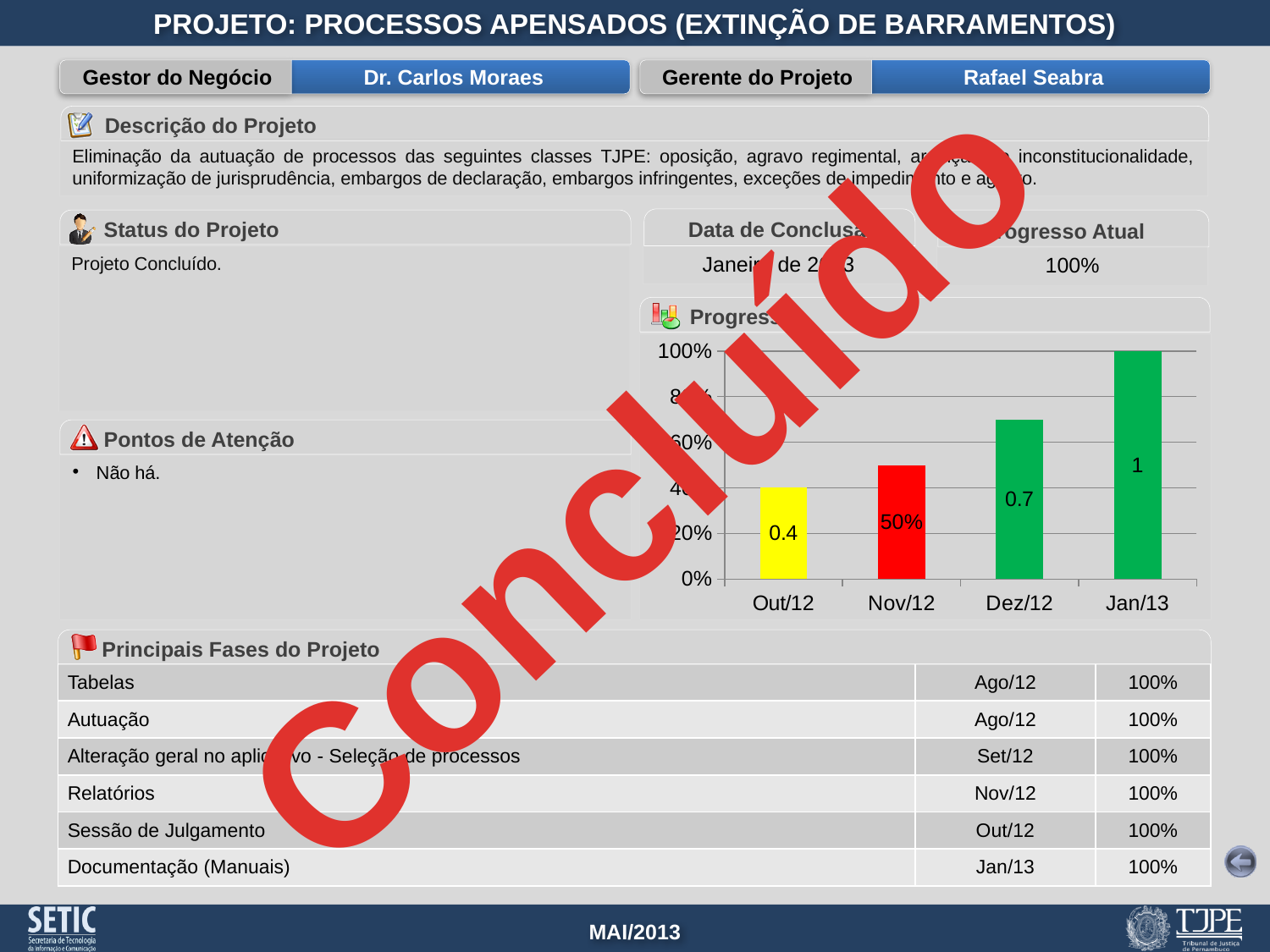
What colour is the bar for Nov/12? red What is the value labelled on the bar for Out/12? 0.4 What is the difference between the labelled values for Jan/13 and Dez/12? 0.3 What kind of chart is shown on the slide? bar chart How many categories are shown on the x axis of the chart? 4 Which month has the highest bar in the chart? Jan/13 What is the value labelled on the bar for Jan/13? 1 Do the bar values rise or fall from Out/12 to Jan/13? rise What is the value labelled on the bar for Dez/12? 0.7 Which is larger, the bar for Dez/12 or the bar for Nov/12? Dez/12 What is the value labelled on the bar for Nov/12? 50% Which month has the lowest bar in the chart? Out/12